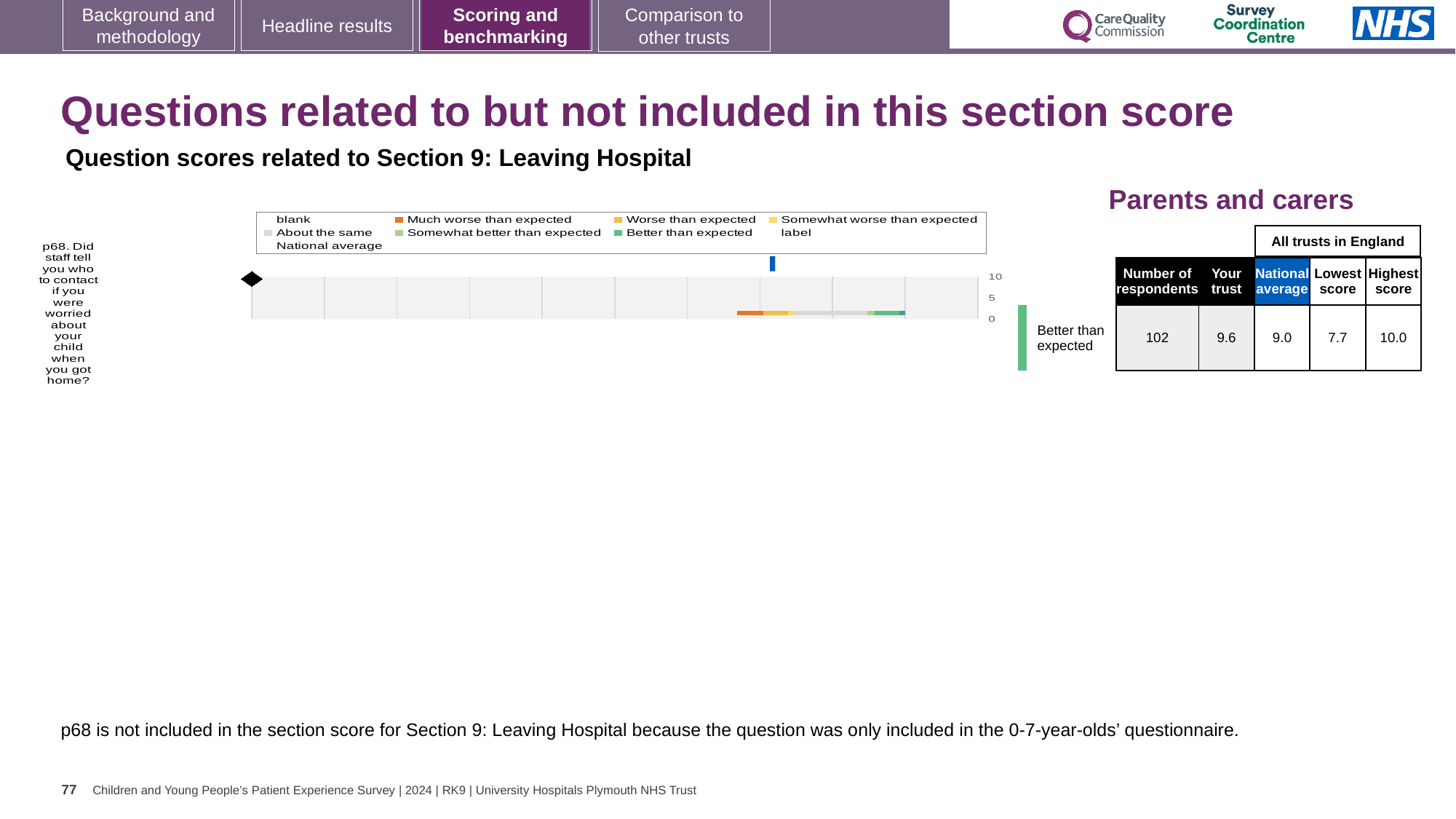
Which question is plotted in the chart? p68. Did staff tell you who to contact if you were worried about your child when you got home? How many survey questions are plotted in the chart? 1 What is the difference between the highest score and the lowest score for p68 across all trusts in England? 2.3 What is the number of respondents for p68? 102 Which expected-range category is the trust's result for p68 labelled as? Better than expected What colour represents 'Better than expected' in the chart legend? green What is the highest value shown on the chart's axis? 10 Is the national average marker for p68 greater or less than 5 on the chart's axis? greater Which is larger for p68, the 'Your trust' score or the national average? Your trust What is the national average score for p68 in the Parents and carers table? 9.0 What kind of chart is shown for question p68? bar chart What is the 'Your trust' score for p68 in the Parents and carers table? 9.6